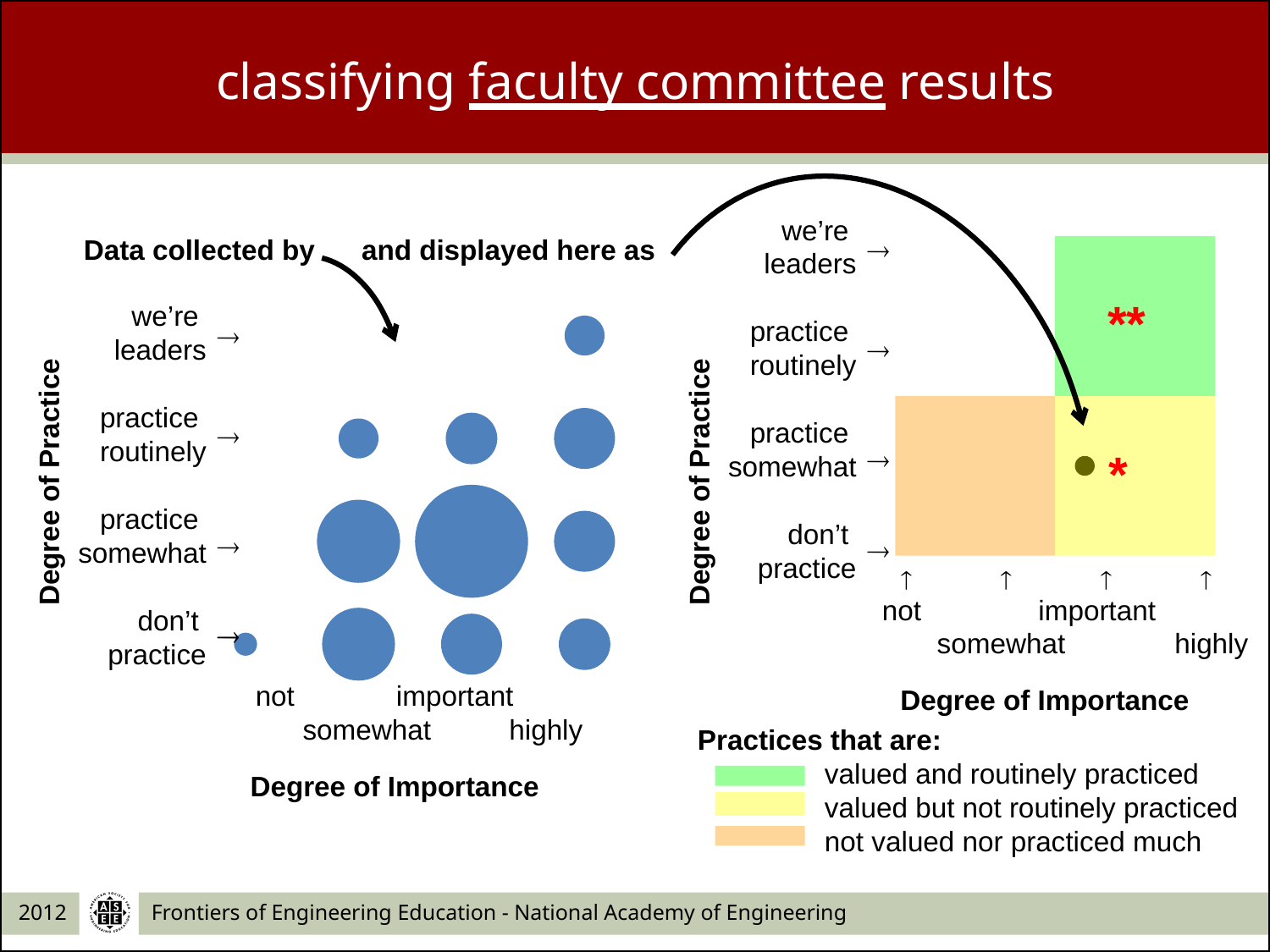
On the right chart, in which coloured region does the plotted dot fall? yellow (valued but not routinely practiced) On the right chart, how many categories does the 'Practices that are:' legend list? 3 On the left bubble chart, what is the label of the vertical axis? Degree of Practice On the right chart, which colour represents practices that are valued but not routinely practiced? yellow On the left bubble chart, how many bubbles are plotted in the 'we're leaders' row? 1 On the left bubble chart, what is the label of the horizontal axis? Degree of Importance On the left bubble chart, how many Degree of Practice categories are listed on the vertical axis? 4 What kind of chart is the left chart, 'Data collected by'? bubble chart On the left bubble chart, which combination of Degree of Importance and Degree of Practice has the largest bubble? important / practice somewhat On the left bubble chart, which bubble is larger: 'practice somewhat' at 'important' or 'practice somewhat' at 'highly important'? practice somewhat at important On the left bubble chart, which bubble is larger: 'practice routinely' at 'somewhat important' or 'practice routinely' at 'highly important'? practice routinely at highly important On the left bubble chart, which combination of Degree of Importance and Degree of Practice has the smallest bubble? not important / don't practice